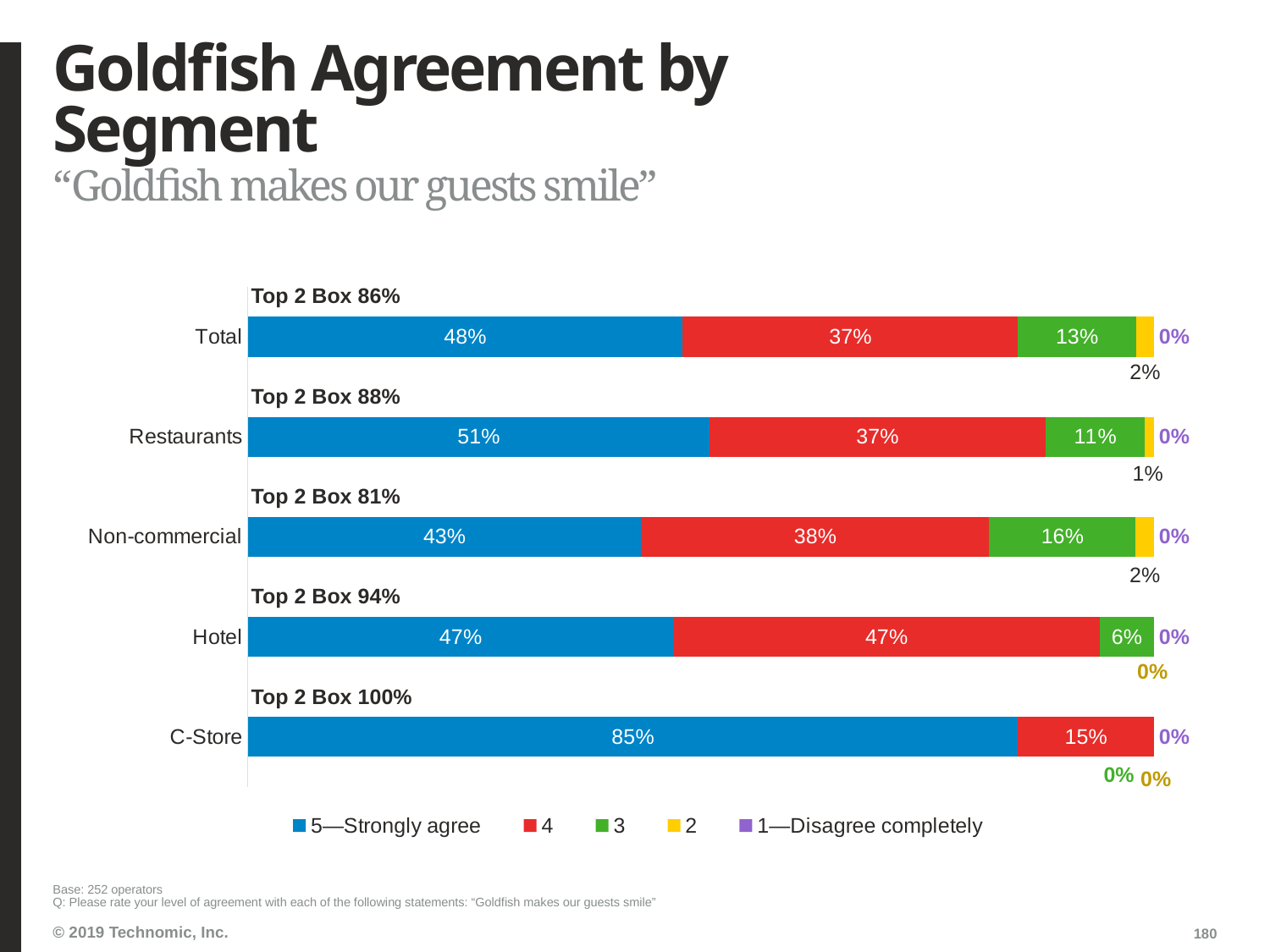
What is the combined total of the "5—Strongly agree" and "4" values for Non-commercial? 81% How many series does the legend list? 5 What is the Top 2 Box value shown for Hotel? 94% Which segment has the highest "5—Strongly agree" percentage? C-Store Which is larger, the "4" value for Hotel or the "4" value for Restaurants? Hotel What percentage of C-Store operators selected "5—Strongly agree"? 85% What is the subtitle quoted under the chart title? "Goldfish makes our guests smile" Which segment has the lowest "5—Strongly agree" percentage? Non-commercial What is the difference between the "5—Strongly agree" values for Restaurants and Total? 3% How many segments are shown on the chart? 5 What is the "3" value for Non-commercial? 16% What kind of chart is shown on the slide? Stacked bar chart